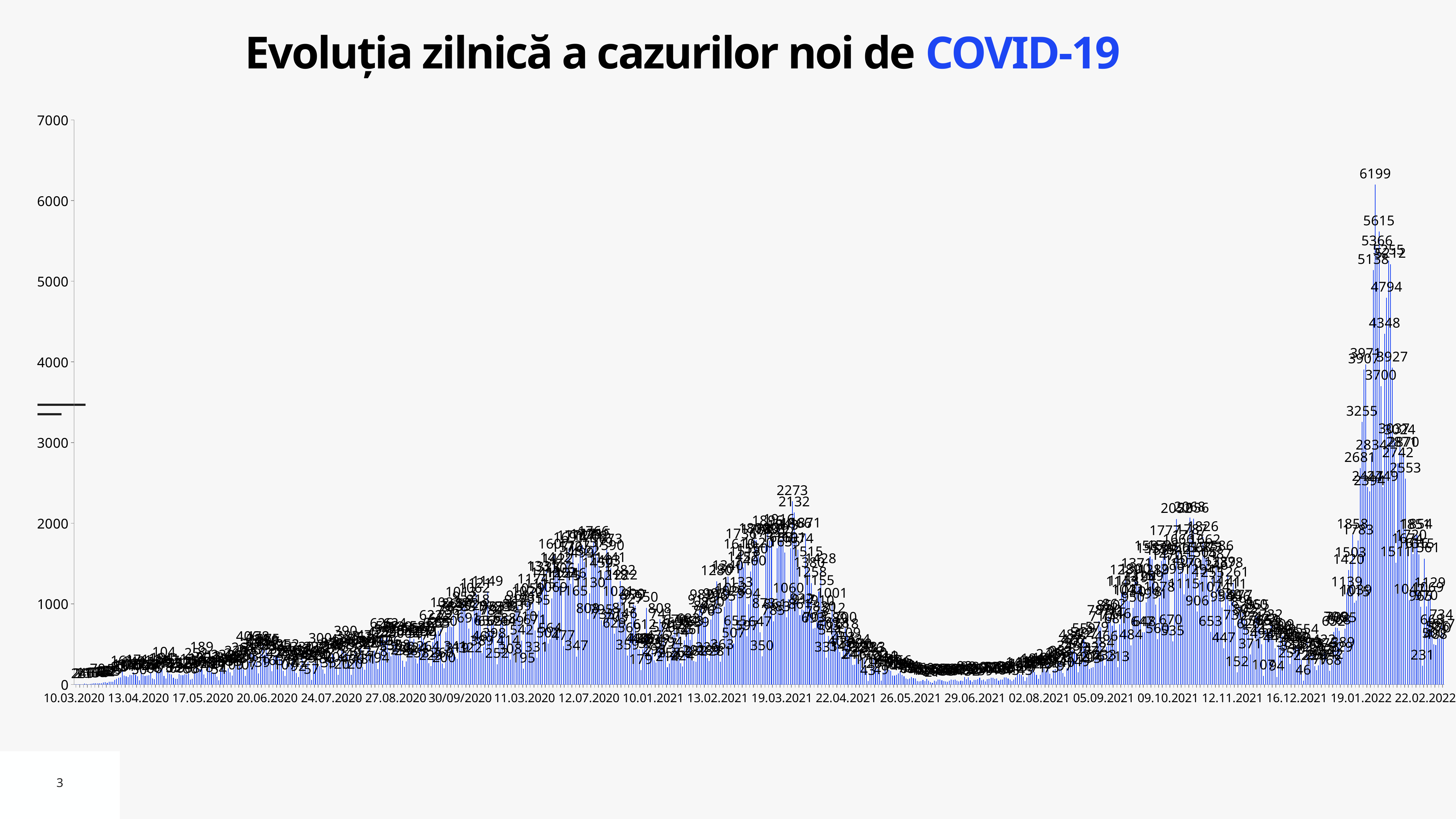
In which year does the highest peak of the chart occur? 2022 Which is larger: the peak in early 2022 or the peak in March 2021? the peak in early 2022 What is the highest tick value shown on the vertical axis? 7000 What is the highest labeled value in the peak around 19.03.2021? 2273 Do the values rise or fall between 05.09.2021 and 09.10.2021? rise What is the title of the chart? Evoluția zilnică a cazurilor noi de COVID-19 What is the highest daily value labeled on the chart? 6199 What is the second highest value labeled on the chart, next to the 6199 peak? 5615 What kind of chart is shown on the slide? bar chart What is the difference between the overall peak value of 6199 and the March 2021 peak value of 2273? 3926 Is the highest value on the chart greater or less than 6000? greater What is the difference between the two highest labeled values, 6199 and 5615? 584